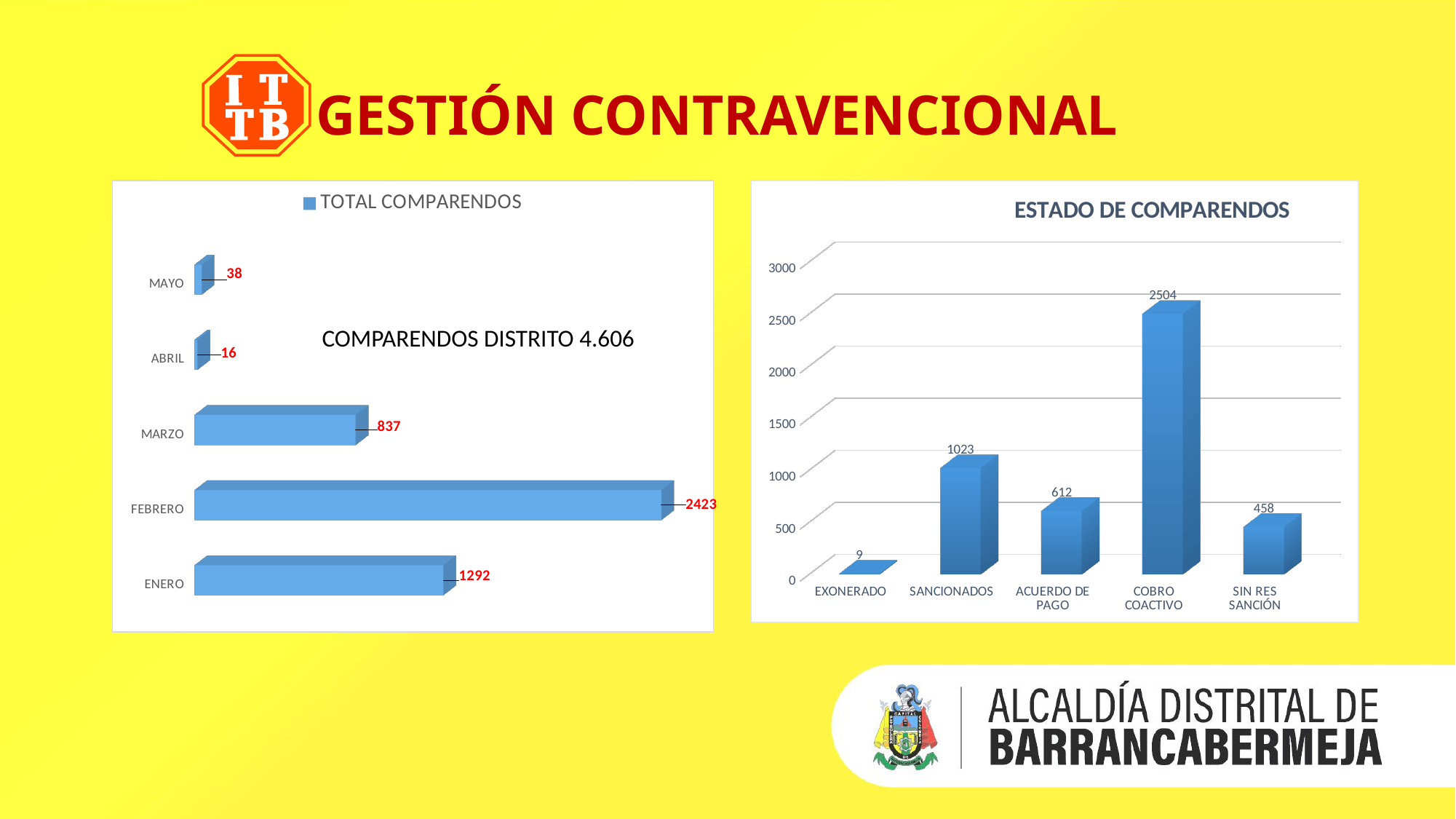
In the TOTAL COMPARENDOS chart on the left, what is the value for FEBRERO? 2423 In the TOTAL COMPARENDOS chart on the left, what kind of chart is it? Bar chart In the ESTADO DE COMPARENDOS chart on the right, what is the difference between COBRO COACTIVO and SANCIONADOS? 1481 In the ESTADO DE COMPARENDOS chart on the right, which category has the highest value? COBRO COACTIVO In the ESTADO DE COMPARENDOS chart on the right, how many categories are shown on the x axis? 5 In the ESTADO DE COMPARENDOS chart on the right, what is the value for SANCIONADOS? 1023 In the TOTAL COMPARENDOS chart on the left, which month has the highest value? FEBRERO In the ESTADO DE COMPARENDOS chart on the right, which category has the lowest value? EXONERADO In the TOTAL COMPARENDOS chart on the left, what is the difference between ENERO and MARZO? 455 In the TOTAL COMPARENDOS chart on the left, which month has the lowest value? ABRIL In the ESTADO DE COMPARENDOS chart on the right, which is larger, ACUERDO DE PAGO or SIN RES SANCIÓN? ACUERDO DE PAGO In the TOTAL COMPARENDOS chart on the left, how many months are shown? 5